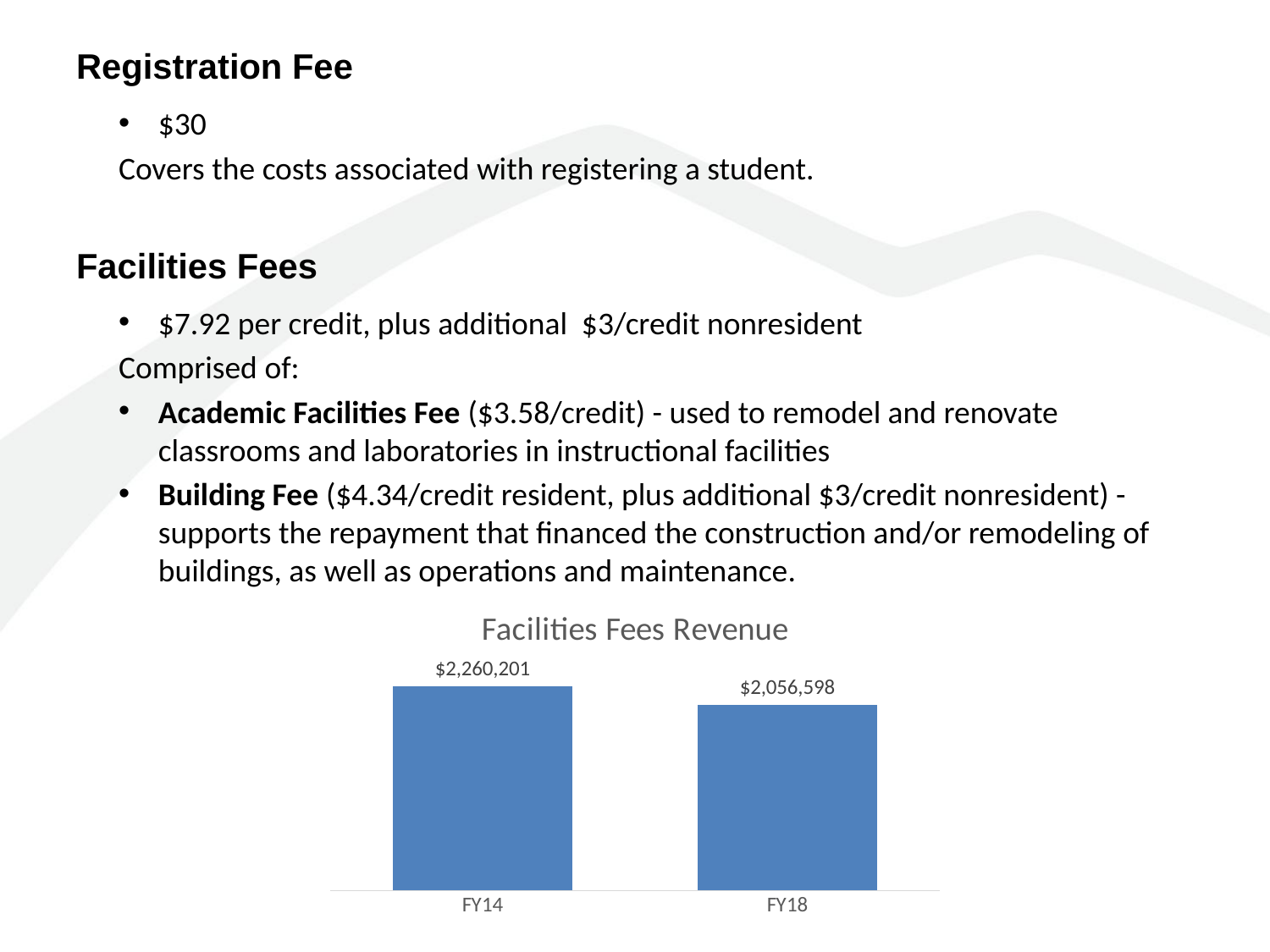
What colour are the bars in the Facilities Fees Revenue chart? Blue What is the title of the chart on the slide? Facilities Fees Revenue What is the Facilities Fees Revenue for FY18? $2,056,598 What is the difference between the FY14 and FY18 Facilities Fees Revenue? $203,603 How many fiscal years are shown in the Facilities Fees Revenue chart? 2 Which fiscal year has the higher Facilities Fees Revenue? FY14 Does the Facilities Fees Revenue rise or fall from FY14 to FY18? Fall Which fiscal year has the lower Facilities Fees Revenue? FY18 What is the Facilities Fees Revenue for FY14? $2,260,201 What kind of chart is used to show Facilities Fees Revenue? Bar chart Is the Facilities Fees Revenue larger in FY14 or FY18? FY14